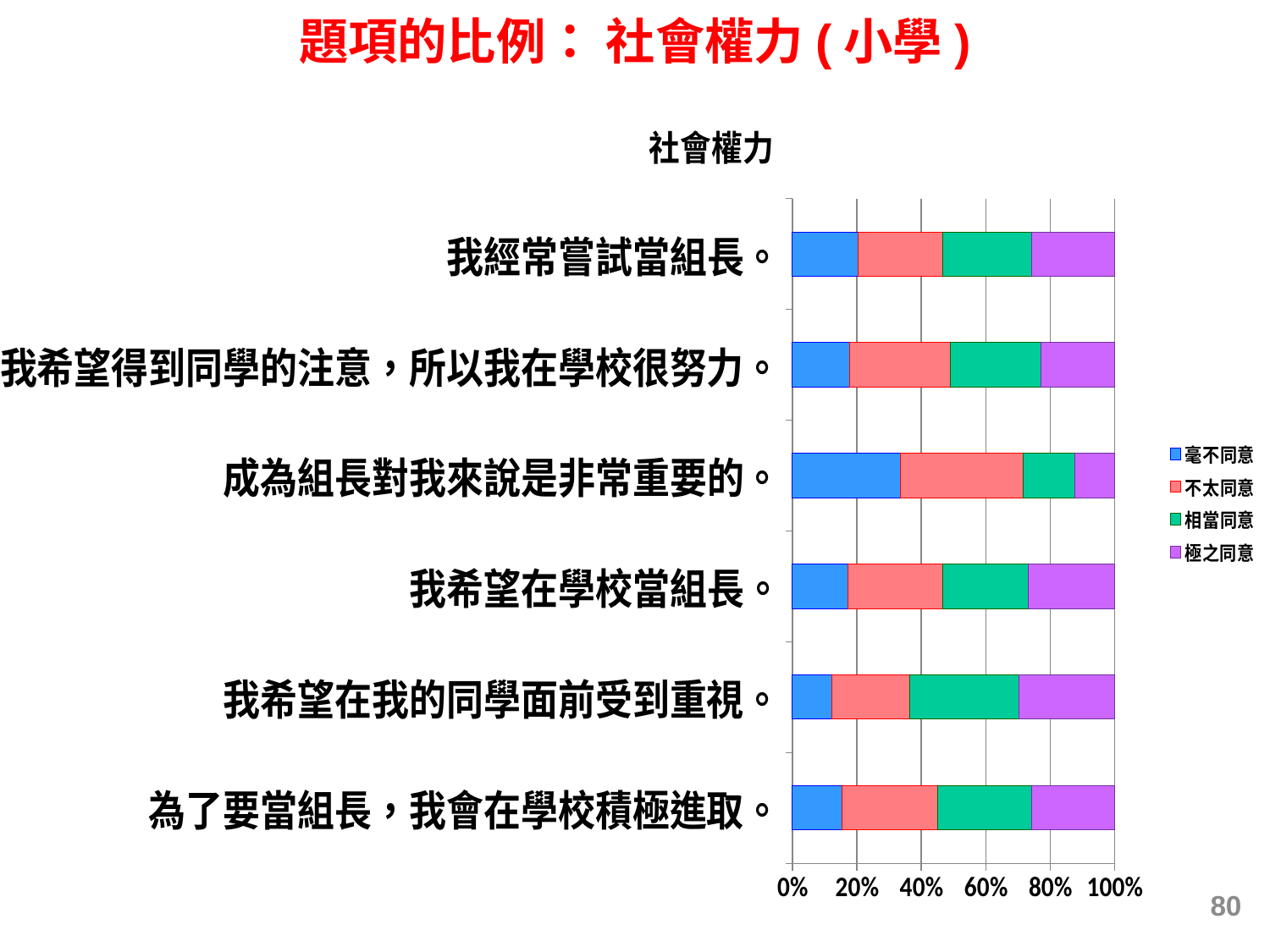
What kind of chart is shown on the slide? Stacked bar chart Which colour represents 相當同意 in the chart? Green What does each stacked bar total on the x axis? 100% Which has the larger 毫不同意 share: 成為組長對我來說是非常重要的。 or 我經常嘗試當組長。? 成為組長對我來說是非常重要的。 Is the 毫不同意 share for 我希望在我的同學面前受到重視。 greater or less than 20%? less Which statement has the smallest 極之同意 share? 成為組長對我來說是非常重要的。 Is the 毫不同意 share for 成為組長對我來說是非常重要的。 greater or less than 20%? greater Which statement has the smallest 毫不同意 share? 我希望在我的同學面前受到重視。 How many statements (categories) are plotted in the chart? 6 Which statement has the largest 毫不同意 share? 成為組長對我來說是非常重要的。 What is the title of the chart? 社會權力 How many series does the legend list? 4